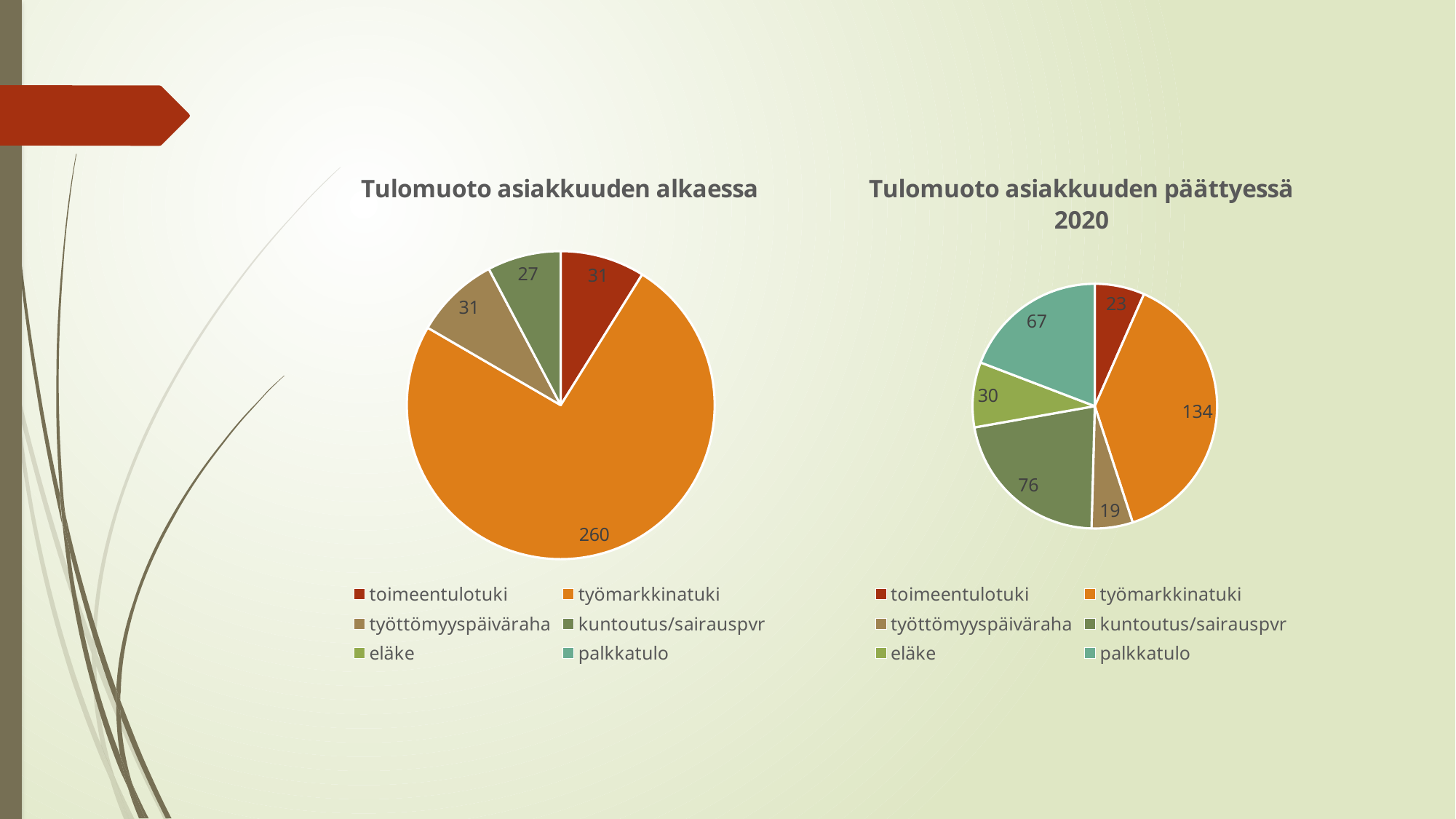
In the chart titled "Tulomuoto asiakkuuden päättyessä 2020", what is the difference between the values for kuntoutus/sairauspvr and palkkatulo? 9 How many labelled slices does the chart titled "Tulomuoto asiakkuuden päättyessä 2020" have? 6 In the chart titled "Tulomuoto asiakkuuden päättyessä 2020", which is larger, the value for toimeentulotuki or the value for eläke? eläke In the chart titled "Tulomuoto asiakkuuden alkaessa", which category has the smallest labelled slice? kuntoutus/sairauspvr In the chart titled "Tulomuoto asiakkuuden päättyessä 2020", which category has the smallest slice? työttömyyspäiväraha What kind of chart is the chart titled "Tulomuoto asiakkuuden alkaessa"? pie chart In the chart titled "Tulomuoto asiakkuuden päättyessä 2020", which category has the largest slice? työmarkkinatuki In the chart titled "Tulomuoto asiakkuuden alkaessa", what is the value for työmarkkinatuki? 260 What is the difference between the työmarkkinatuki value in the left chart and the työmarkkinatuki value in the right chart? 126 In the chart titled "Tulomuoto asiakkuuden päättyessä 2020", what is the value for palkkatulo? 67 In the chart titled "Tulomuoto asiakkuuden alkaessa", what is the value for kuntoutus/sairauspvr? 27 In the chart titled "Tulomuoto asiakkuuden päättyessä 2020", what is the value for eläke? 30